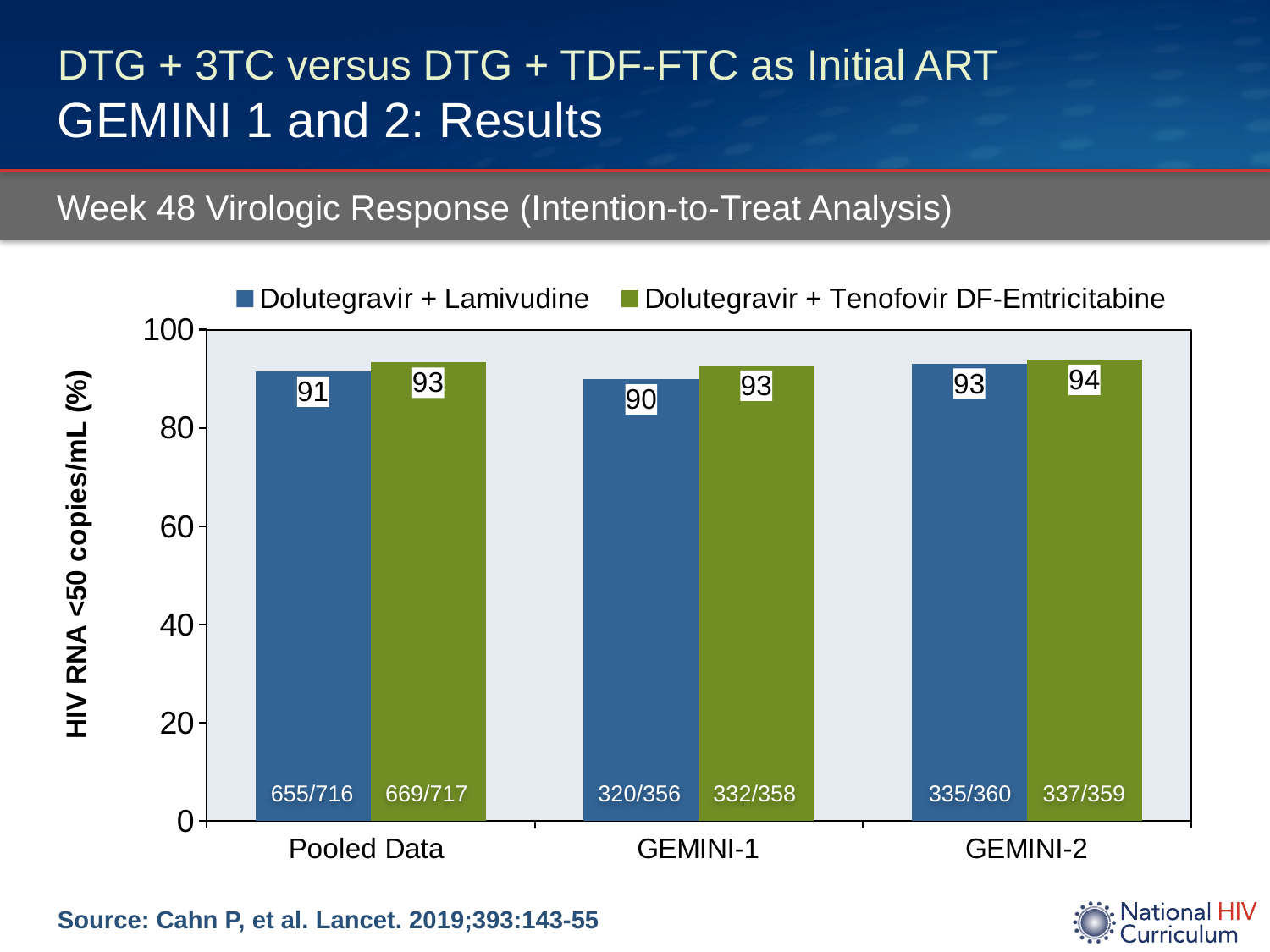
What kind of chart is shown on the slide? Bar chart Which series has the higher value in GEMINI-1? Dolutegravir + Tenofovir DF-Emtricitabine What is the value for Dolutegravir + Lamivudine in the Pooled Data category? 91 What is the value for Dolutegravir + Tenofovir DF-Emtricitabine in GEMINI-2? 94 What is the difference between the two series values in the Pooled Data category? 2 What is the value for Dolutegravir + Tenofovir DF-Emtricitabine in GEMINI-1? 93 What is the label of the y axis? HIV RNA <50 copies/mL (%) What is the difference between the Dolutegravir + Tenofovir DF-Emtricitabine and Dolutegravir + Lamivudine values in GEMINI-1? 3 How many categories are shown on the x axis? 3 What is the value for Dolutegravir + Lamivudine in GEMINI-2? 93 What fraction is printed at the base of the Dolutegravir + Lamivudine bar for GEMINI-1? 320/356 How many series does the legend list? 2